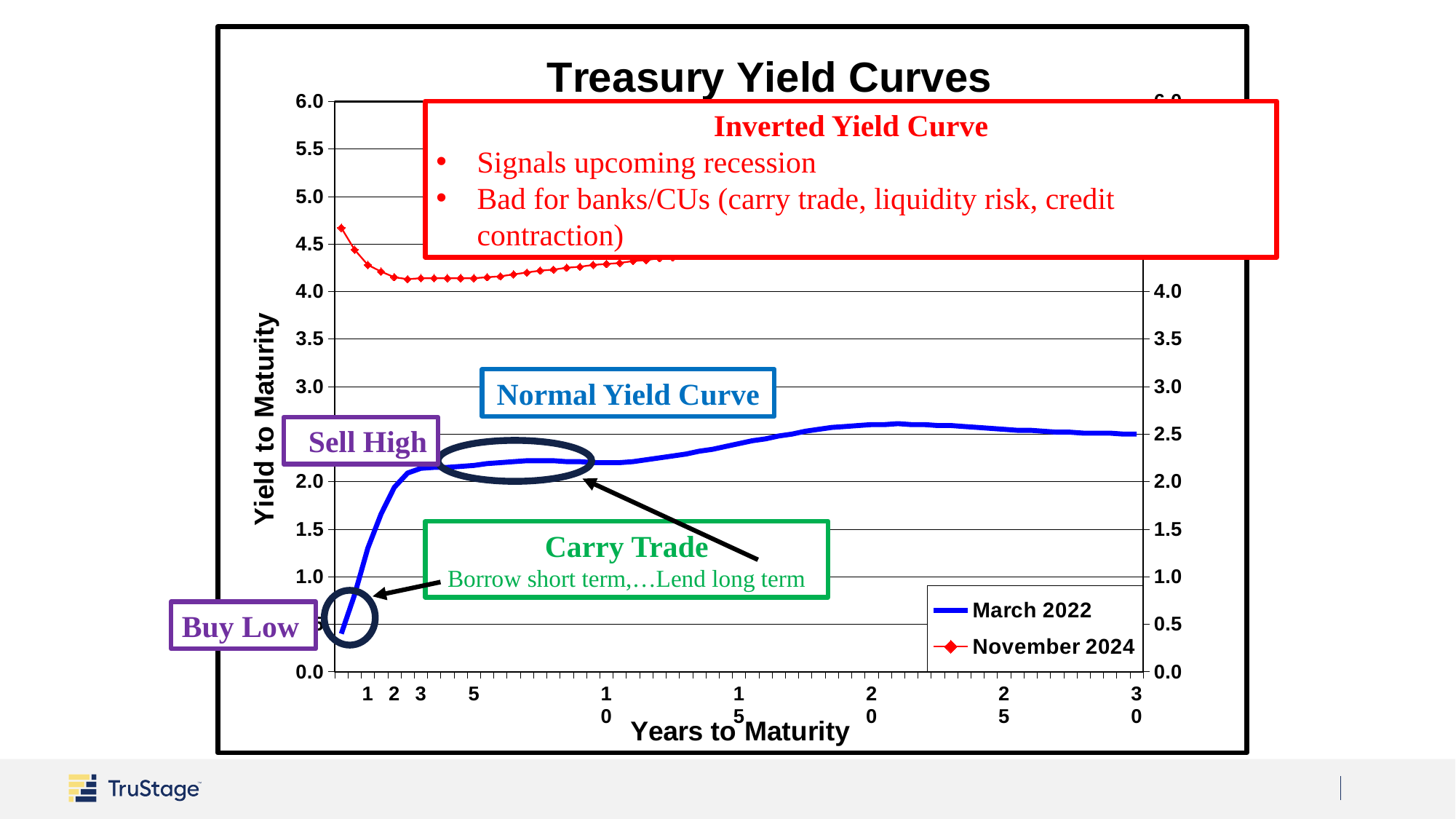
Does the March 2022 curve rise or fall between 1 and 5 years to maturity? rise What is the title of the chart? Treasury Yield Curves Is the March 2022 yield at 30 years to maturity greater or less than 3.0? less Does the November 2024 curve rise or fall between 1 and 3 years to maturity? fall Is the March 2022 yield at 1 year to maturity greater or less than 1.0? greater What are the two series named in the legend? March 2022 and November 2024 What kind of chart is shown on the slide? line chart Is the November 2024 yield at 5 years to maturity greater or less than 4.0? greater At 5 years to maturity, which series has the higher yield, March 2022 or November 2024? November 2024 How many series does the legend list? 2